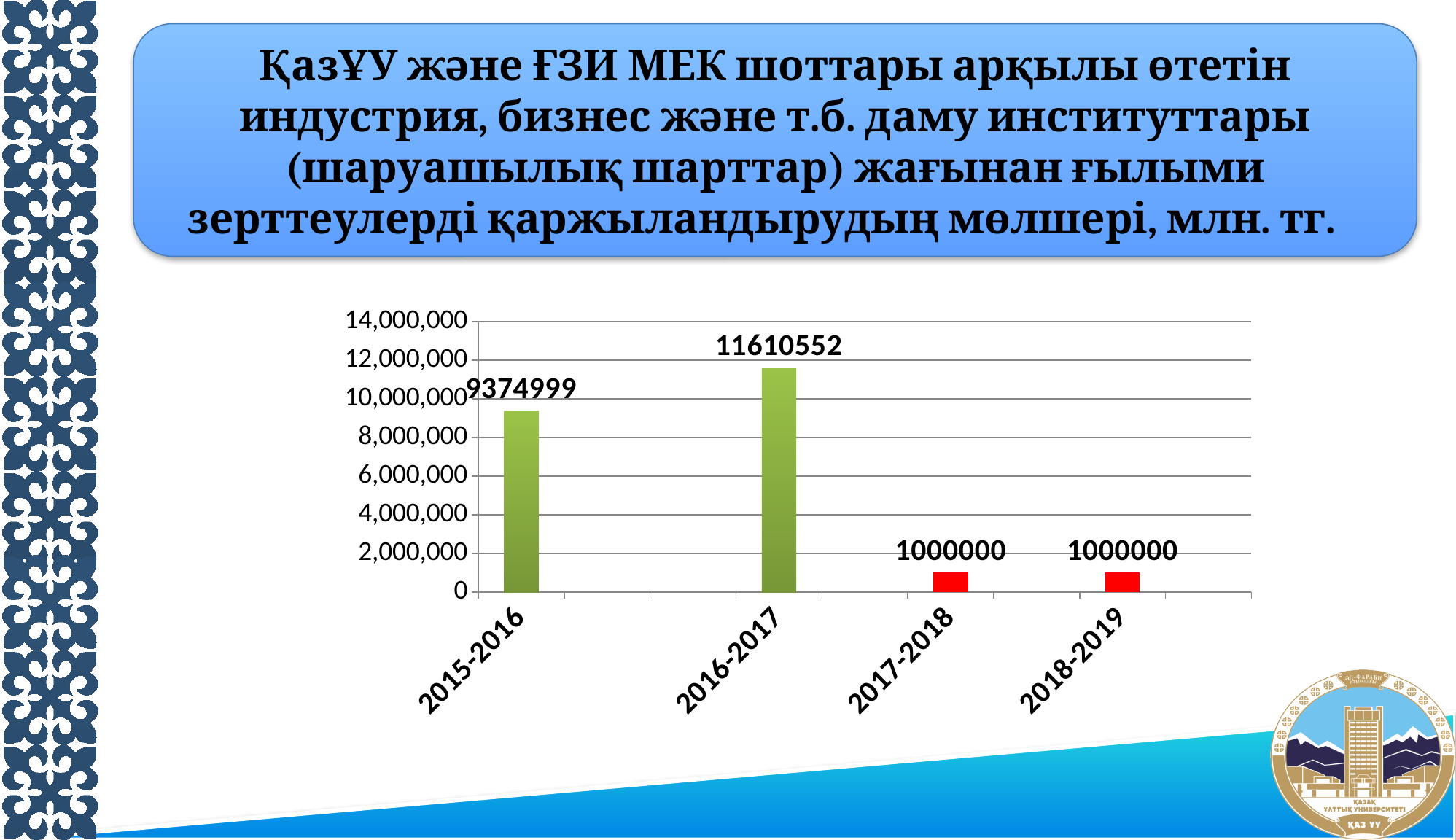
What is the value for 2015-2016? 9374999 What is the difference between the values for 2015-2016 and 2017-2018? 8374999 Which is larger, the value for 2015-2016 or the value for 2016-2017? 2016-2017 How many periods are shown on the x axis? 4 What is the value for 2018-2019? 1000000 What is the value for 2016-2017? 11610552 What kind of chart is shown on the slide? bar chart Is the value for 2016-2017 greater or less than 10,000,000? greater What is the difference between the values for 2016-2017 and 2015-2016? 2235553 What is the value for 2017-2018? 1000000 Which period has the highest value? 2016-2017 What colour are the bars for 2017-2018 and 2018-2019? red